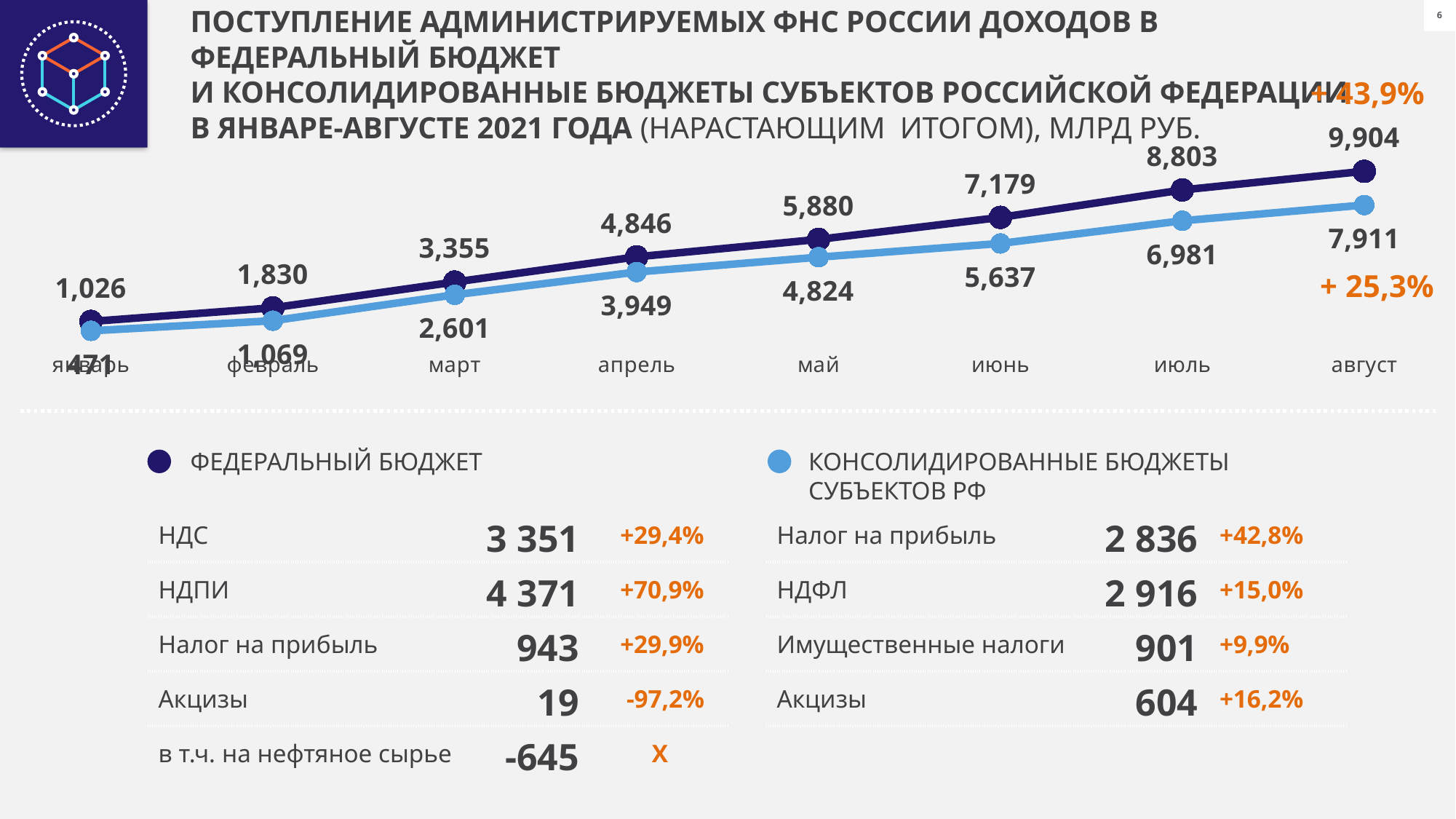
Do the values of the ФЕДЕРАЛЬНЫЙ БЮДЖЕТ series rise or fall from январь to август? rise How many months are plotted along the x axis of the chart? 8 What type of chart is shown on the slide? line chart What is the value for ФЕДЕРАЛЬНЫЙ БЮДЖЕТ in апрель? 4,846 How many series does the chart's legend list? 2 In which month is the ФЕДЕРАЛЬНЫЙ БЮДЖЕТ series at its highest? август What is the difference between ФЕДЕРАЛЬНЫЙ БЮДЖЕТ and КОНСОЛИДИРОВАННЫЕ БЮДЖЕТЫ СУБЪЕКТОВ РФ in август? 1,993 In which month is the ФЕДЕРАЛЬНЫЙ БЮДЖЕТ series at its lowest? январь What is the value for ФЕДЕРАЛЬНЫЙ БЮДЖЕТ in август? 9,904 What is the value for КОНСОЛИДИРОВАННЫЕ БЮДЖЕТЫ СУБЪЕКТОВ РФ in май? 4,824 Which series has the larger value in июнь, ФЕДЕРАЛЬНЫЙ БЮДЖЕТ or КОНСОЛИДИРОВАННЫЕ БЮДЖЕТЫ СУБЪЕКТОВ РФ? ФЕДЕРАЛЬНЫЙ БЮДЖЕТ What is the value for КОНСОЛИДИРОВАННЫЕ БЮДЖЕТЫ СУБЪЕКТОВ РФ in июль? 6,981